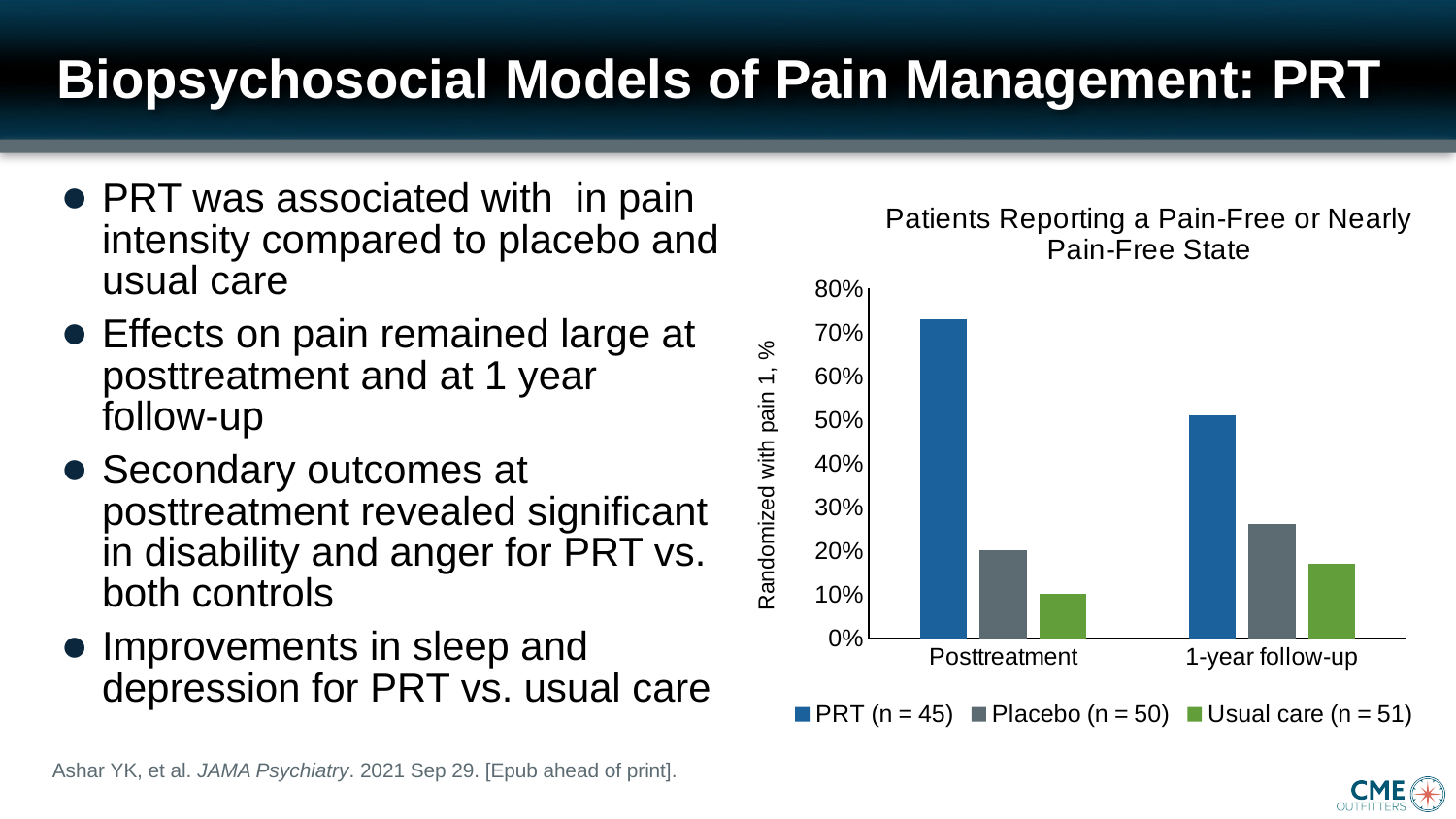
Is the value for Usual care at 1-year follow-up greater or less than 20%? less Which series has the highest value at Posttreatment? PRT (n = 45) Is the value for PRT at 1-year follow-up greater or less than 40%? greater What is the label of the y axis of the chart? Randomized with pain 1, % How many categories are shown on the x axis of the chart? 2 What kind of chart is shown on the slide? bar chart What is the title of the chart? Patients Reporting a Pain-Free or Nearly Pain-Free State How many series does the chart legend list? 3 Is the value for Placebo at 1-year follow-up greater or less than 30%? less Which is larger: the PRT value at Posttreatment or the PRT value at 1-year follow-up? Posttreatment Which series has the lowest value at 1-year follow-up? Usual care (n = 51)